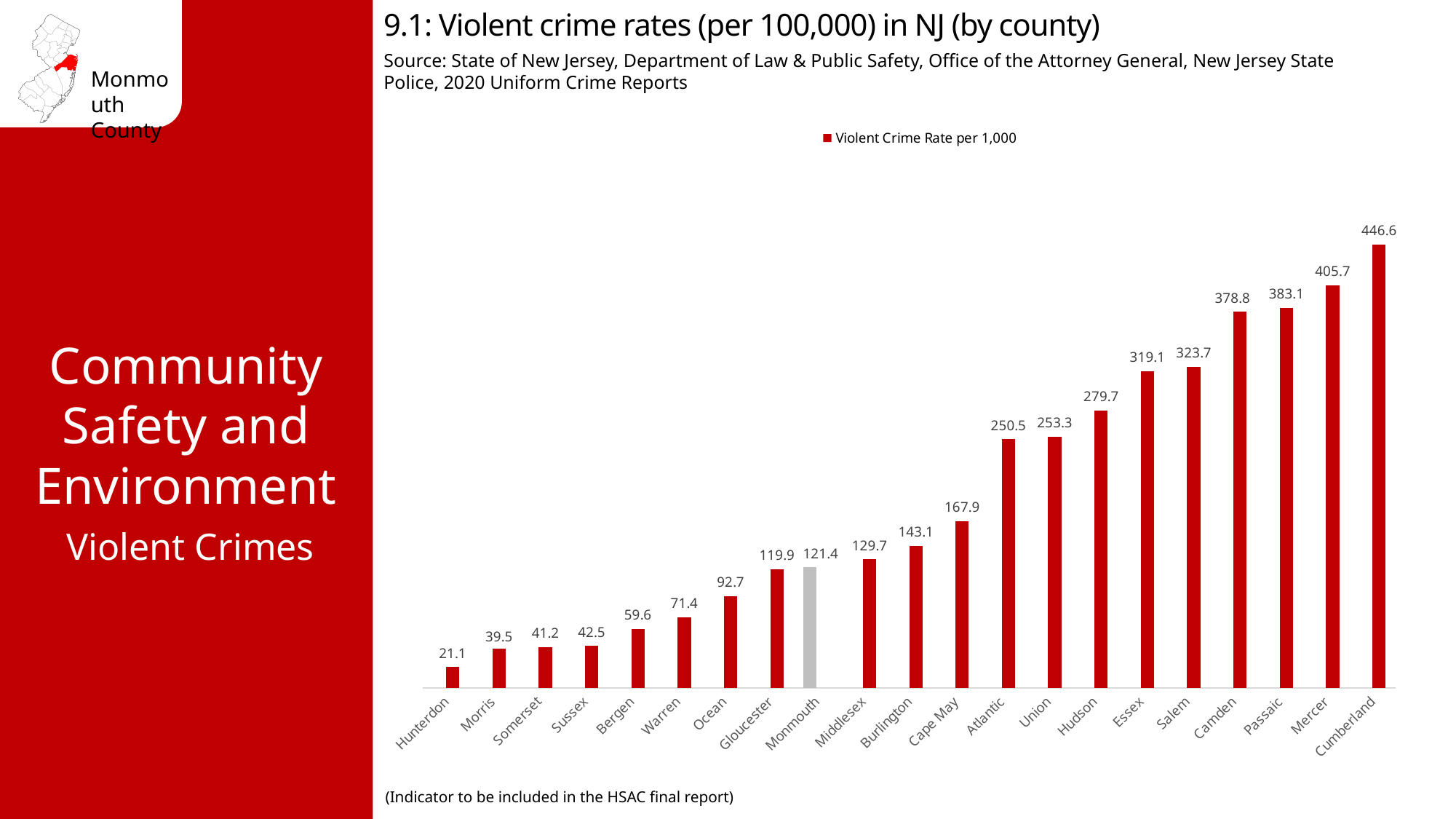
Which county has the lowest violent crime rate? Hunterdon Do the values rise or fall moving from left to right along the x axis? Rise What is the violent crime rate for Monmouth? 121.4 What kind of chart is shown on the slide? Bar chart What is the difference between the violent crime rates of Mercer and Camden? 26.9 How many series does the legend list? 1 What is the violent crime rate for Cape May? 167.9 How many counties are shown in the chart? 21 What is the violent crime rate for Hudson? 279.7 Which county has the highest violent crime rate? Cumberland What is the difference between the violent crime rates of Cumberland and Hunterdon? 425.5 Which has a higher violent crime rate, Essex or Atlantic? Essex